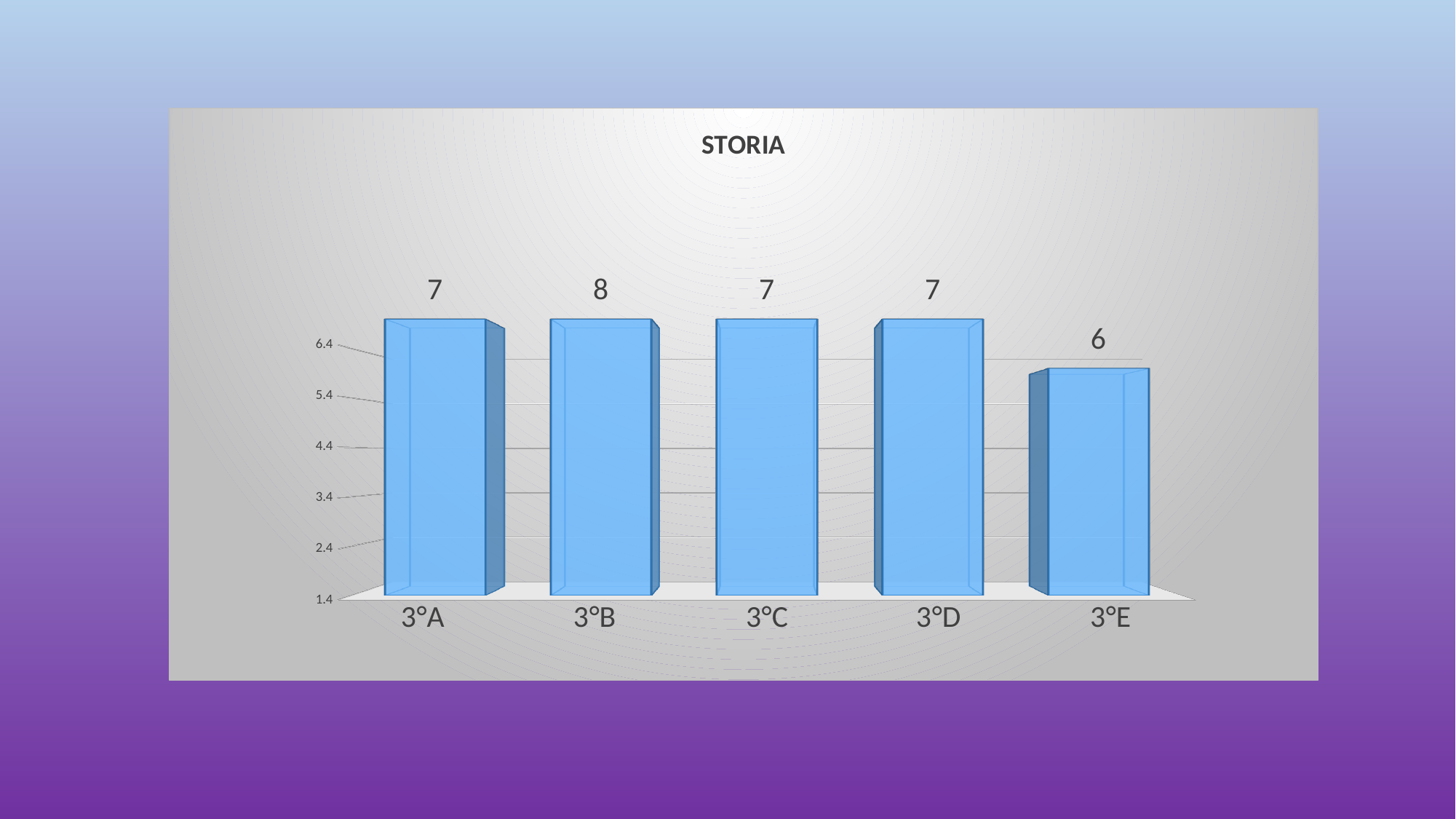
What is the difference between the values for 3°D and 3°E? 1 What is the difference between the values for 3°B and 3°E? 2 What is the value for 3°E? 6 What is the title of the chart? STORIA What is the value for 3°A? 7 Which is larger, the value for 3°C or the value for 3°E? 3°C How many categories are shown on the x axis? 5 What is the value for 3°B? 8 What is the value for 3°D? 7 Which category has the lowest value? 3°E Which category has the highest value? 3°B What kind of chart is this? bar chart